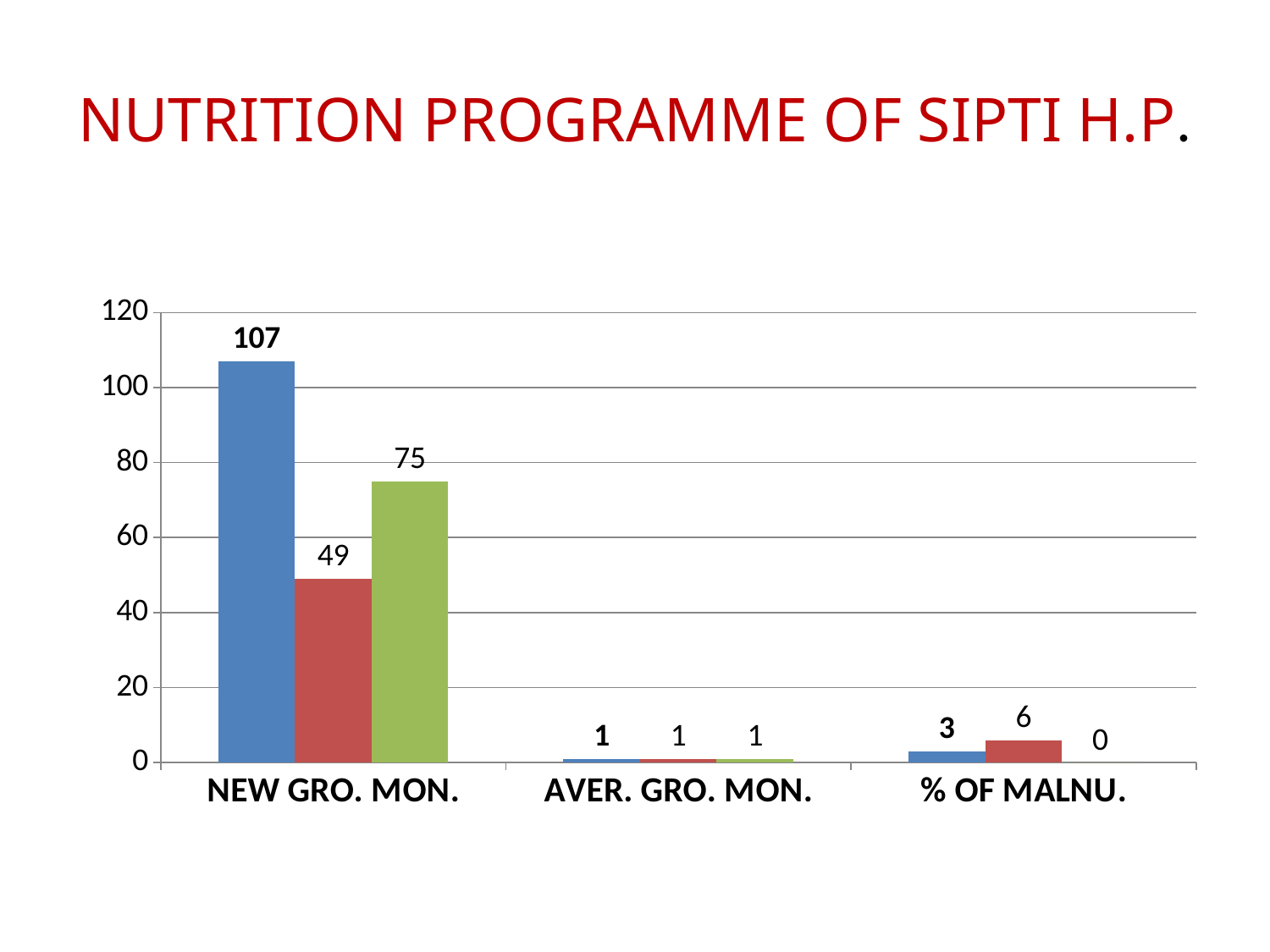
What is the value of the green bar for % OF MALNU.? 0 For % OF MALNU., which is larger, the blue bar or the red bar? the red bar What is the difference between the green and red bars for NEW GRO. MON.? 26 What is the value of the red bar for % OF MALNU.? 6 What is the title of the slide? NUTRITION PROGRAMME OF SIPTI H.P. What is the value of the blue bar for NEW GRO. MON.? 107 What is the difference between the blue and red bars for NEW GRO. MON.? 58 What kind of chart is shown on the slide? bar chart How many categories are shown on the x axis? 3 What is the value of the green bar for NEW GRO. MON.? 75 What is the value of the red bar for NEW GRO. MON.? 49 Which category has the highest blue bar? NEW GRO. MON.